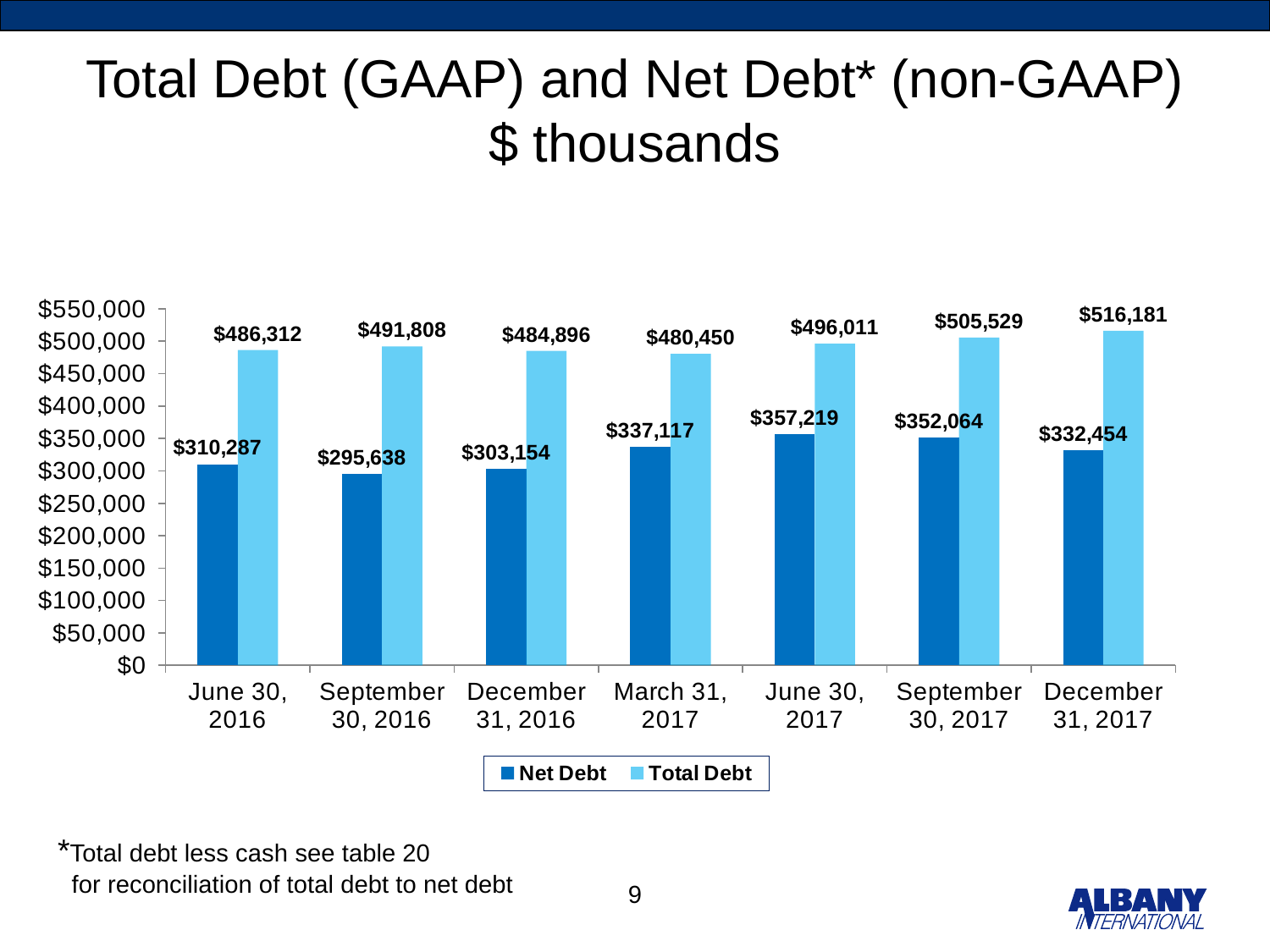
How many periods are shown on the x axis? 7 How many series does the legend list? 2 Which period has the lowest Net Debt? September 30, 2016 Is the Total Debt value for December 31, 2017 greater or less than $500,000? greater What kind of chart is shown on the slide? bar chart What is the Net Debt value for June 30, 2016? $310,287 Is Net Debt higher for September 30, 2017 or December 31, 2017? September 30, 2017 Which period has the lowest Total Debt? March 31, 2017 What is the Total Debt value for March 31, 2017? $480,450 What is the Total Debt value for December 31, 2017? $516,181 Which period has the highest Net Debt? June 30, 2017 What is the difference between Total Debt and Net Debt for December 31, 2017? $183,727